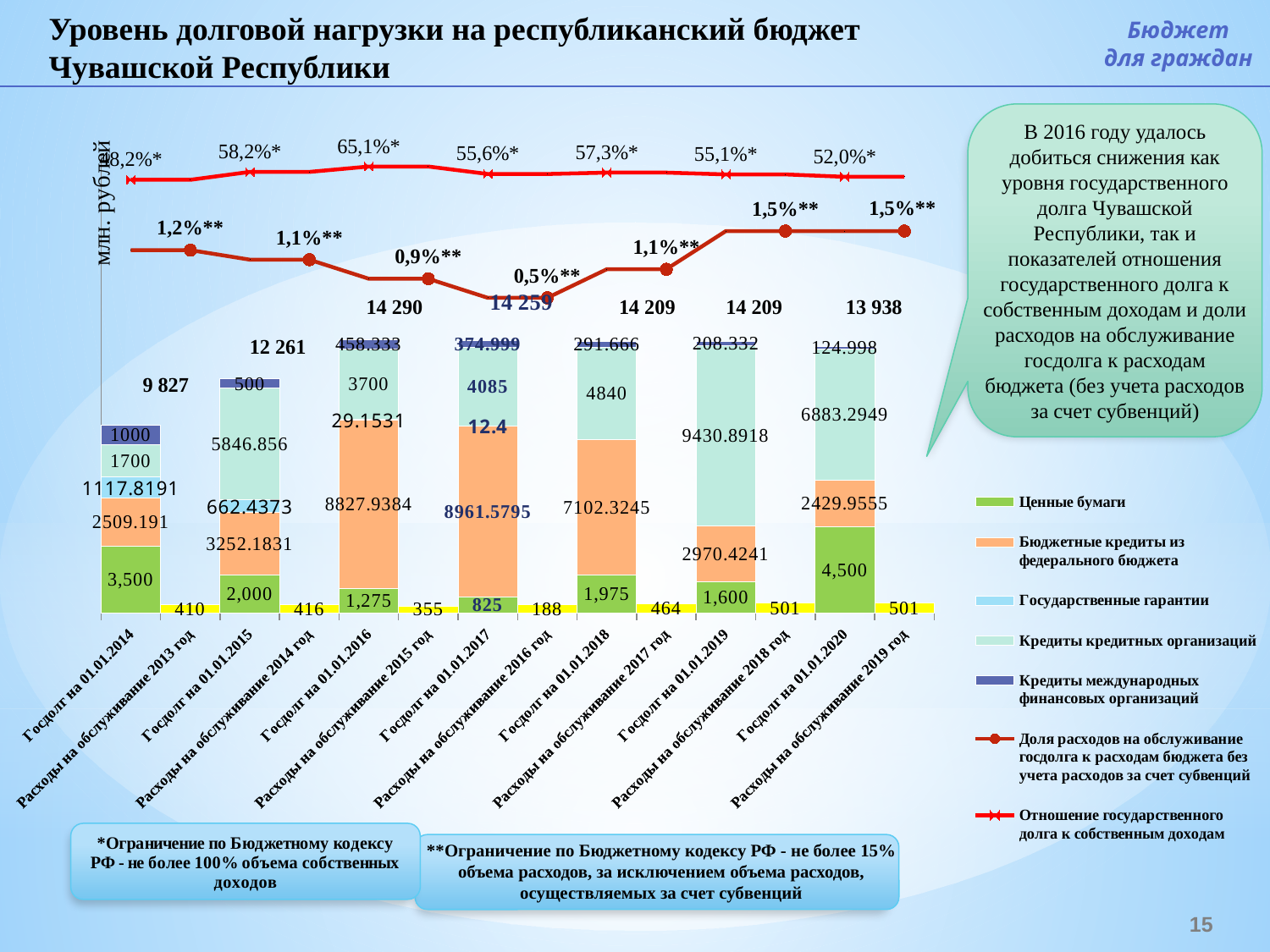
What is the value of Расходы на обслуживание 2016 год? 188 Does the share of debt servicing expenses (Доля расходов на обслуживание госдолга) rise or fall from 01.01.2017 to 01.01.2020? Rises What is the value of Ценные бумаги in the Госдолг на 01.01.2020 bar? 4,500 What is the value of Бюджетные кредиты из федерального бюджета in the Госдолг на 01.01.2018 bar? 7102.3245 What kind of chart is shown on the slide? Stacked bar chart with line series How many Госдолг (state debt) stacked bars are shown on the chart? 7 On which date is the ratio of state debt to own revenues (Отношение государственного долга к собственным доходам) the highest? 01.01.2016 (65,1%) What is the difference between the total state debt on 01.01.2015 and on 01.01.2014? 2 434 What is the total state debt (Госдолг) on 01.01.2016? 14 290 Which is larger: Ценные бумаги on 01.01.2014 or on 01.01.2020? 01.01.2020 What is the lowest value of the share of debt servicing expenses (Доля расходов на обслуживание госдолга) shown on the chart? 0,5% How many entries does the legend list? 7